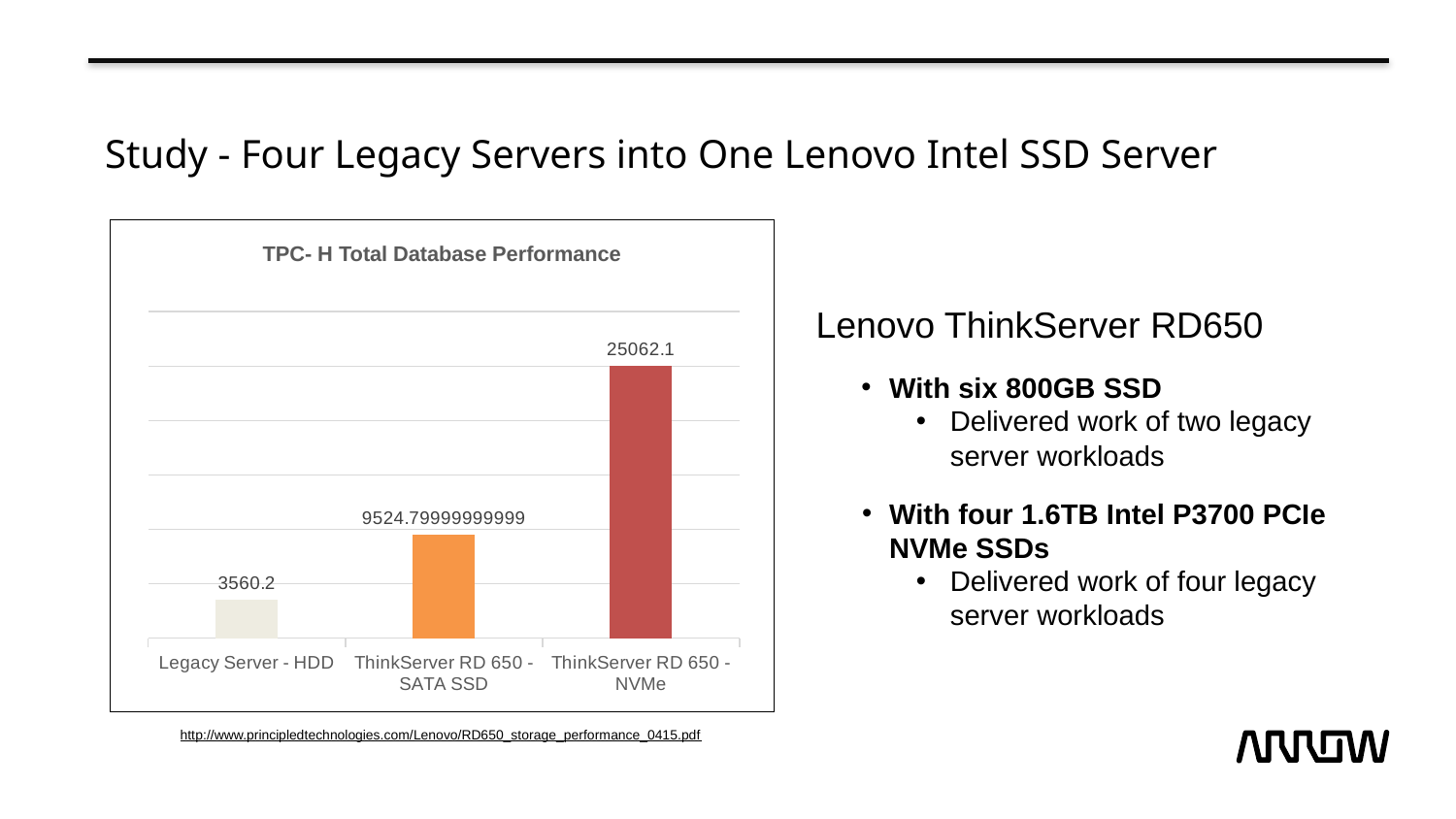
What is the title of the chart? TPC- H Total Database Performance Which category has the highest TPC- H Total Database Performance? ThinkServer RD 650 - NVMe What is the value for Legacy Server - HDD in the TPC- H Total Database Performance chart? 3560.2 Do the values rise or fall from left to right across the categories? Rise Which is larger, the value for ThinkServer RD 650 - SATA SSD or the value for Legacy Server - HDD? ThinkServer RD 650 - SATA SSD Which category has the lowest value in the chart? Legacy Server - HDD What colour is the bar for ThinkServer RD 650 - SATA SSD? Orange What value is shown for ThinkServer RD 650 - SATA SSD? 9524.79999999999 What value is shown for ThinkServer RD 650 - NVMe? 25062.1 How many categories are plotted in the chart? 3 What kind of chart is shown on the slide? Bar chart What is the difference between the ThinkServer RD 650 - NVMe value and the Legacy Server - HDD value? 21501.9